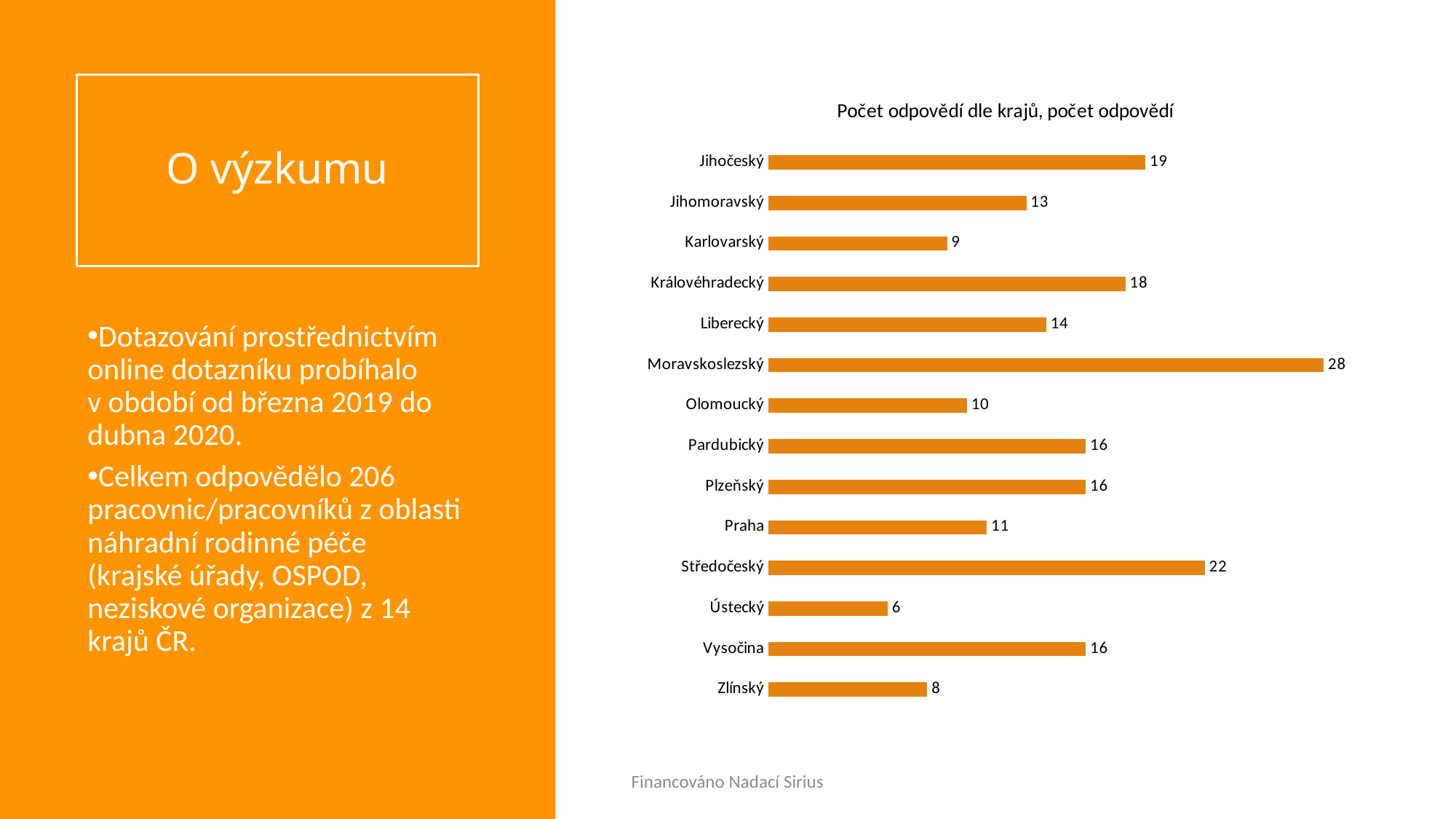
How many regions have a value of 16? 3 What is the value for Praha? 11 What is the difference between the values for Středočeský and Jihočeský? 3 Which is larger, the value for Královéhradecký or the value for Liberecký? Královéhradecký How many regions are shown in the chart? 14 What kind of chart is shown on the slide? bar chart Which region has the highest number of responses? Moravskoslezský Which region has the lowest number of responses? Ústecký What is the difference between the values for Moravskoslezský and Ústecký? 22 What is the value for Moravskoslezský? 28 What is the value for Karlovarský? 9 What is the title of the chart? Počet odpovědí dle krajů, počet odpovědí